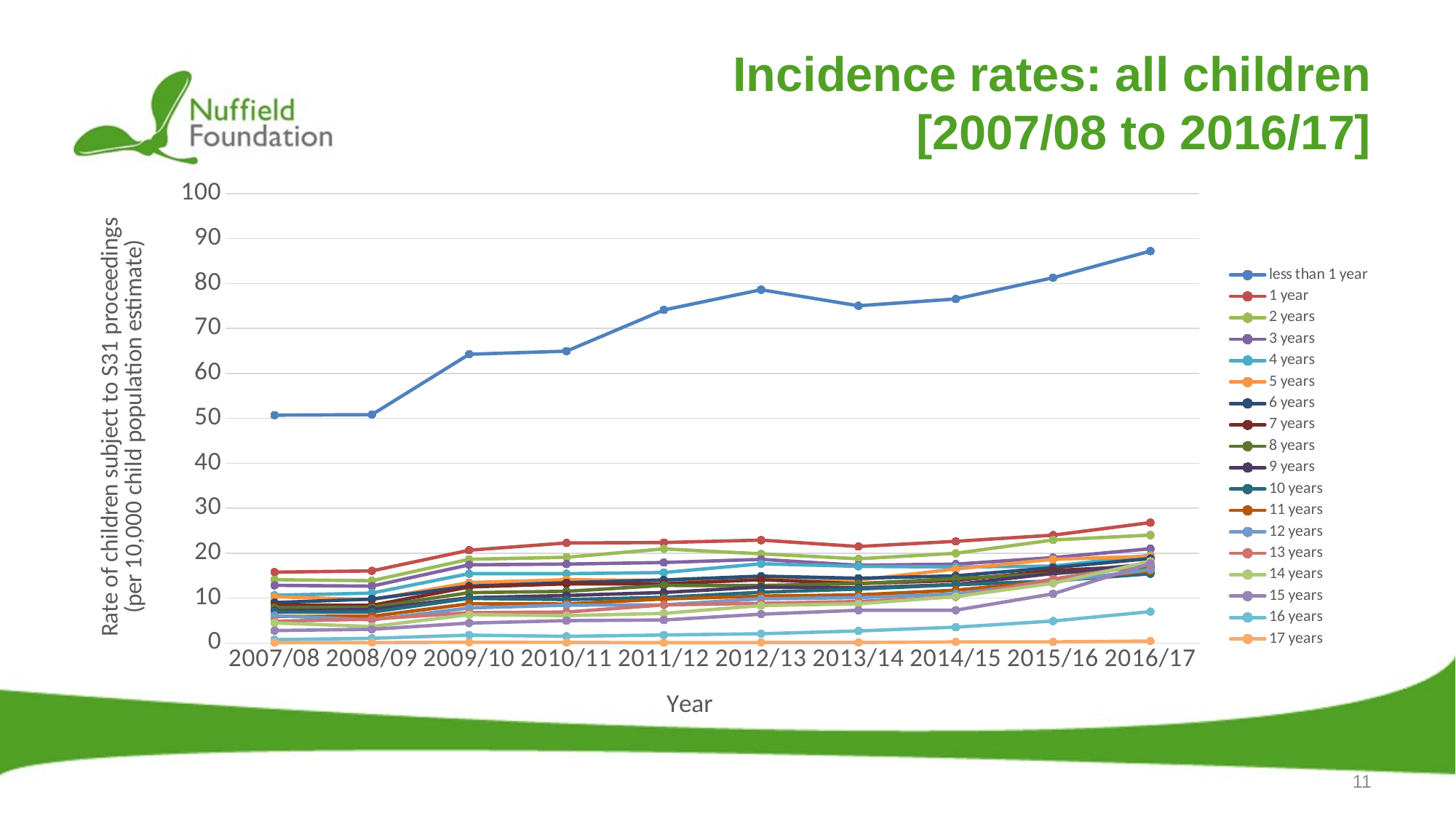
What kind of chart is shown on the slide? line chart In 2012/13, which is larger: the value for 'less than 1 year' or the value for '1 year'? less than 1 year Is the value for '1 year' in 2016/17 greater or less than 20? greater How many series does the chart's legend list? 18 Which series has the lowest incidence rate across the whole period? 17 years Which series has the highest incidence rate in 2016/17? less than 1 year Is the value for '16 years' in 2016/17 greater or less than 10? less Is the value for 'less than 1 year' in 2016/17 greater or less than 80? greater How many years are shown along the x axis of the chart? 10 What is the label on the x axis of the chart? Year Does the incidence rate for 'less than 1 year' rise or fall overall from 2007/08 to 2016/17? rise